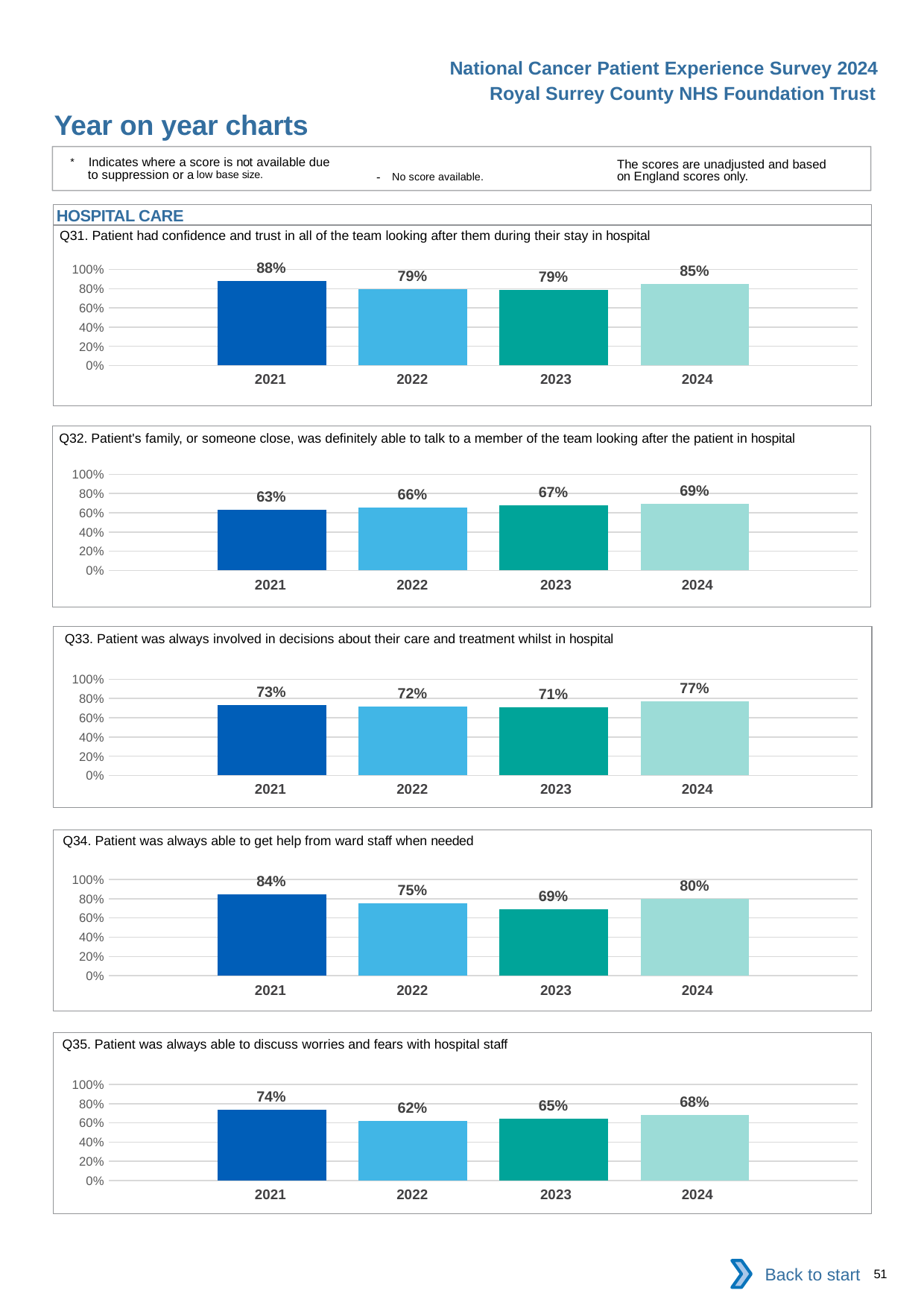
In the Q35 chart, what is the difference between the 2024 and 2023 values? 3% How many charts are shown on the slide? 5 In the Q35 chart, which is larger, the value for 2021 or the value for 2022? 2021 How many years are shown in the Q31 chart? 4 In the Q33 chart, which year has the lowest value? 2023 In the Q33 chart, what is the value for 2024? 77% In the Q34 chart, what is the difference between the 2021 and 2023 values? 15% In the Q32 chart, is the value for 2021 greater or less than 80%? less What kind of chart is the Q34 chart? bar chart In the Q32 chart, which year has the highest value? 2024 In the Q31 chart, what is the value for 2021? 88% In the Q32 chart, do the values rise or fall from 2021 to 2024? rise